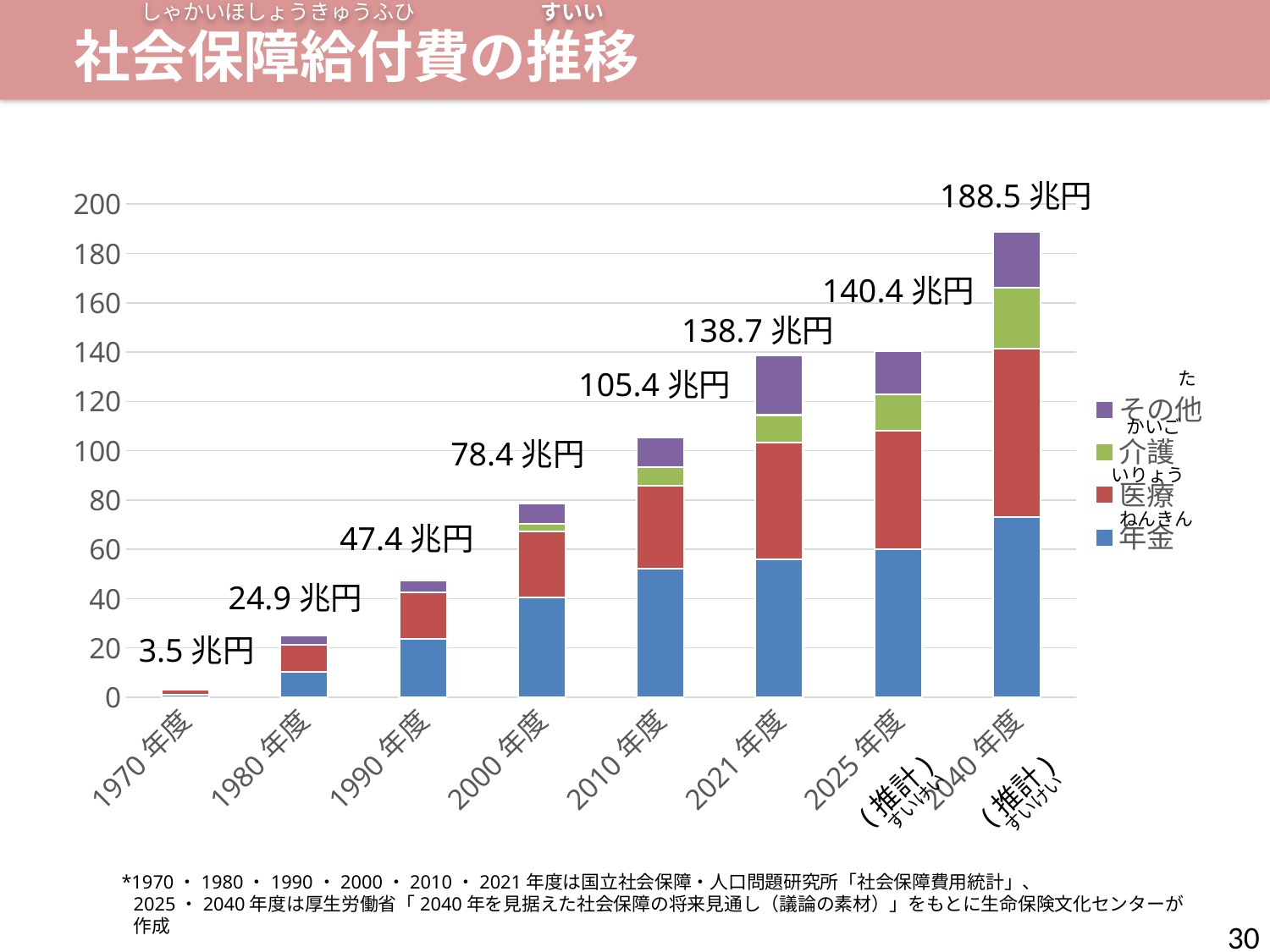
What is the total value labeled for 1970年度? 3.5 兆円 What is the total value labeled for 2010年度? 105.4 兆円 How many series does the legend list? 4 What is the difference between the total for 2021年度 and the total for 2010年度? 33.3 兆円 Which fiscal year has the lowest total social security benefit expenditure? 1970年度 What is the difference between the total for 2040年度（推計） and the total for 2025年度（推計）? 48.1 兆円 Which is larger, the total for 1990年度 or the total for 2000年度? 2000年度 What kind of chart is shown on the slide? Stacked bar chart Is the 年金 segment for 2040年度（推計） greater or less than 60? greater Which fiscal year has the highest total social security benefit expenditure? 2040年度（推計） What is the total social security benefit expenditure shown for 2040年度（推計）? 188.5 兆円 How many fiscal years are shown on the x axis? 8